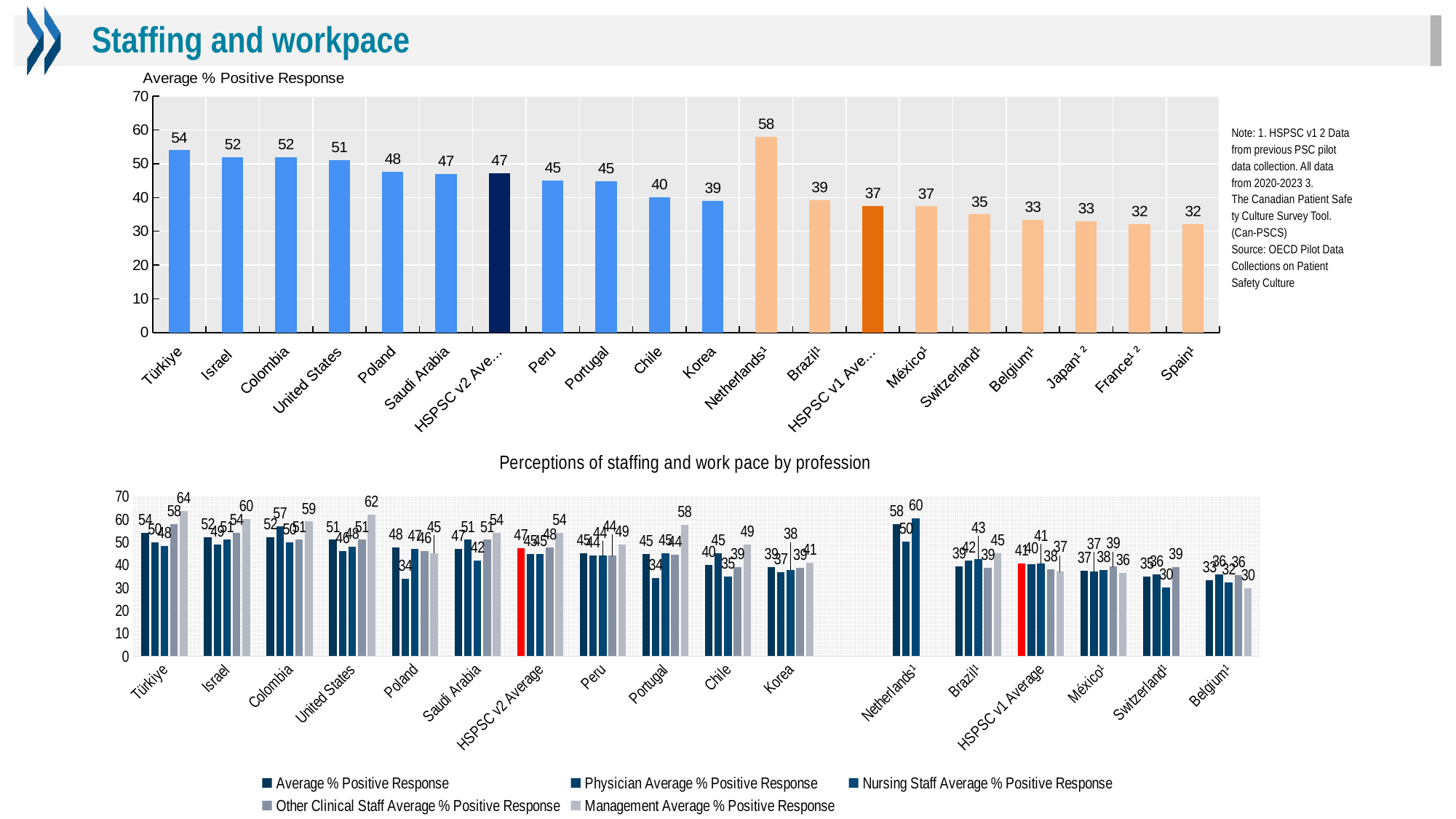
In the bottom chart (Perceptions of staffing and work pace by profession), what is the Physician Average % Positive Response value for Poland? 34 What kind of chart is the top chart on the slide? Bar chart In the top chart (Average % Positive Response), which is larger, the value for Chile or the value for Brazil? Chile In the bottom chart (Perceptions of staffing and work pace by profession), what is the difference between the Management value for Portugal (58) and the Physician value for Portugal (34)? 24 In the top chart (Average % Positive Response), how many bars are plotted? 20 In the bottom chart (Perceptions of staffing and work pace by profession), what is the Management Average % Positive Response value for Türkiye? 64 In the top chart (Average % Positive Response), which country has the highest value? Netherlands In the top chart (Average % Positive Response), what is the difference between the values for Netherlands and Spain? 26 In the bottom chart (Perceptions of staffing and work pace by profession), how many series does the legend list? 5 In the top chart (Average % Positive Response), what is the value for Türkiye? 54 What is the title of the bottom chart on the slide? Perceptions of staffing and work pace by profession In the top chart (Average % Positive Response), what is the value for Switzerland? 35